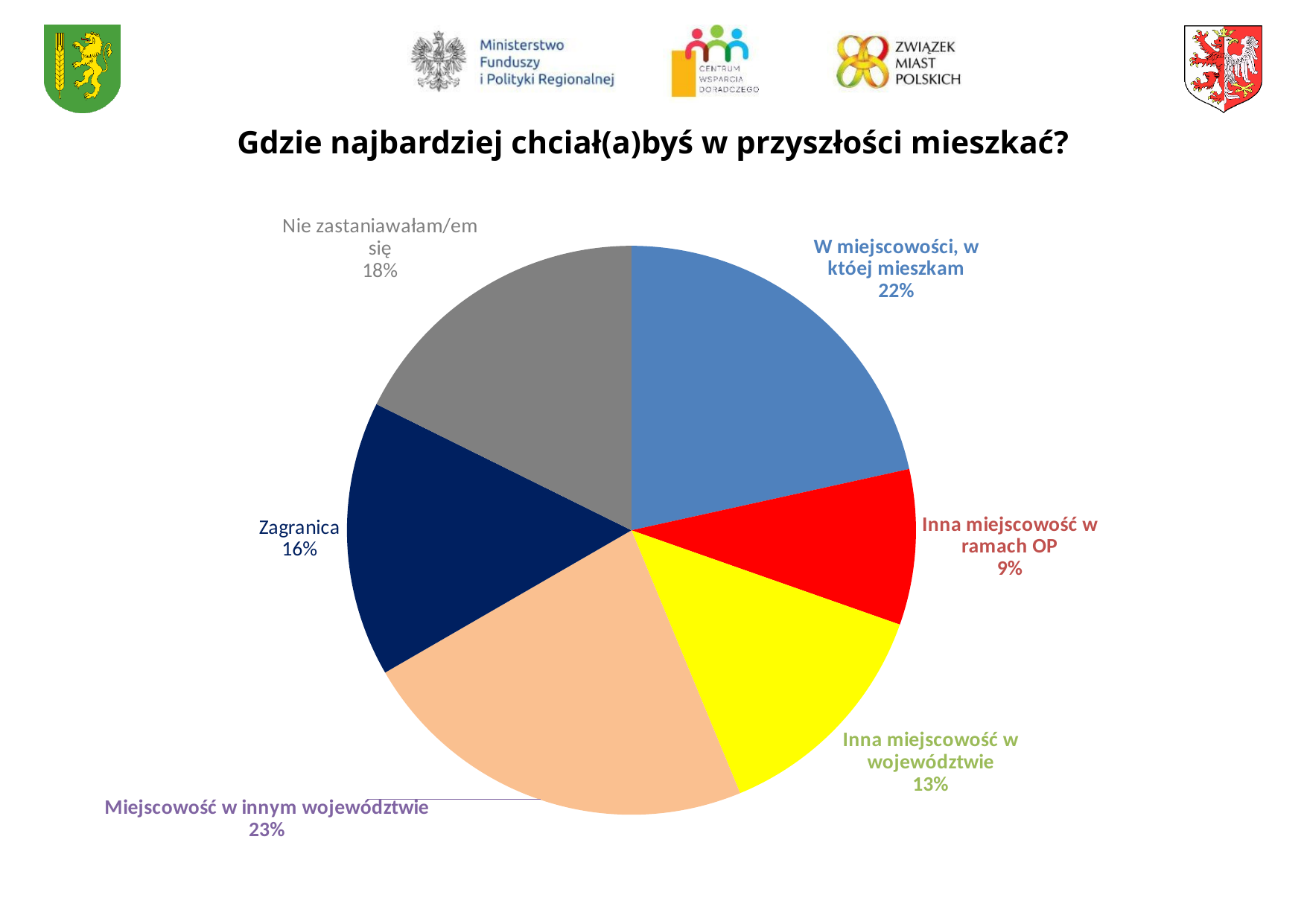
What share of the pie does "Miejscowość w innym województwie" have? 23% What is the title of the chart? Gdzie najbardziej chciał(a)byś w przyszłości mieszkać? Which category has the largest slice? Miejscowość w innym województwie What is the difference between "W miejscowości, w której mieszkam" and "Inna miejscowość w województwie"? 9% What is the value for "Inna miejscowość w ramach OP"? 9% What kind of chart is shown on the slide? Pie chart Which is larger, "Zagranica" or "Nie zastaniawałam/em się"? Nie zastaniawałam/em się What is the value for "W miejscowości, w której mieszkam"? 22% What is the value for "Zagranica"? 16% How many categories are shown in the pie chart? 6 Which category has the smallest slice? Inna miejscowość w ramach OP What is the value for "Nie zastaniawałam/em się"? 18%